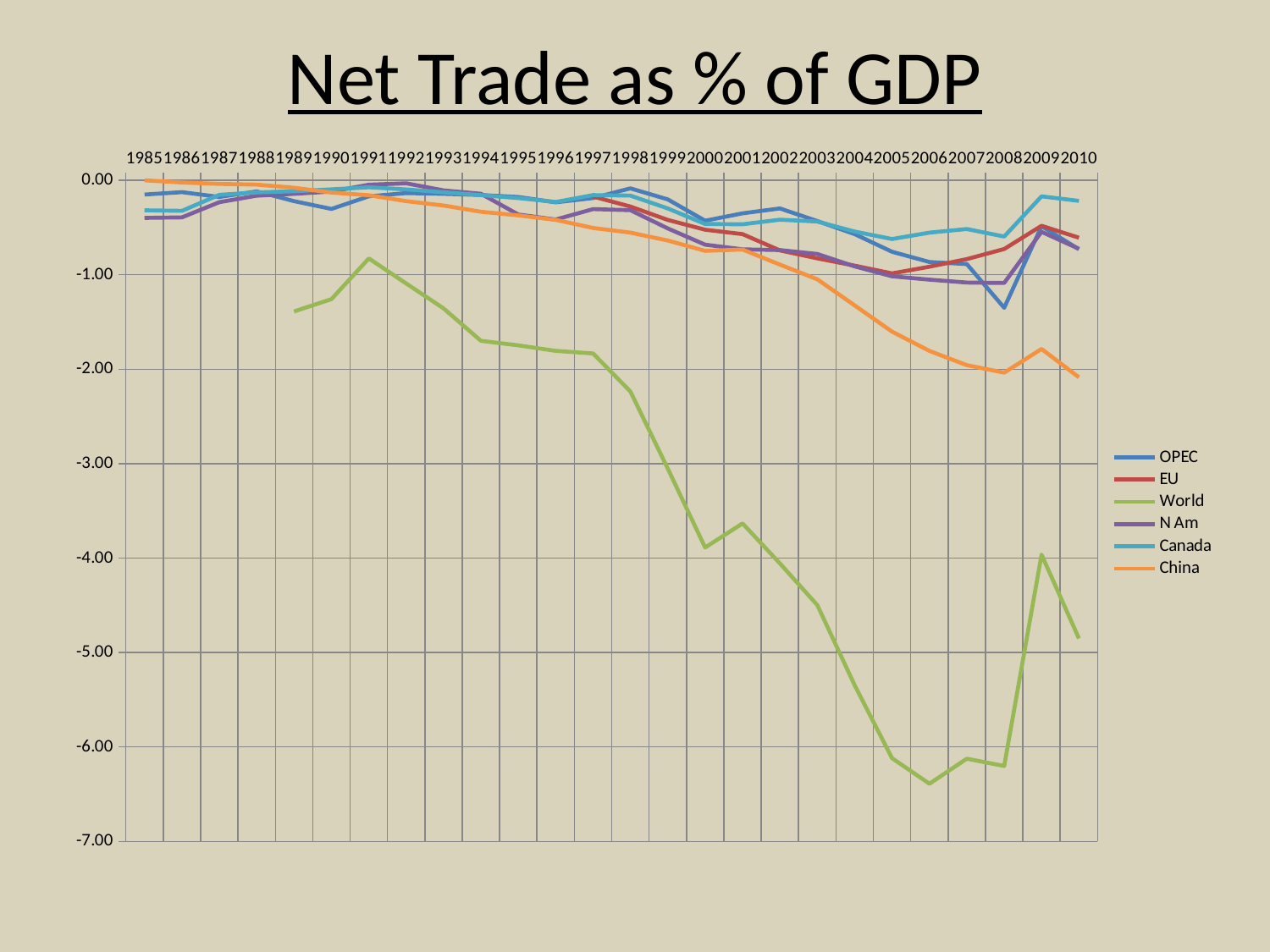
Which series is drawn in orange in the legend? China Is the value for World in 2003 greater or less than -4.00? less Is the value for Canada in 2010 greater or less than -1.00? greater Does the World line rise or fall between 1991 and 2006? fall Which series has the lowest value in 2006? World How many series does the legend list? 6 What is the title of the chart? Net Trade as % of GDP What kind of chart is shown on the slide? line chart Which series has the highest value in 2010? Canada How many years are shown along the x axis? 26 Is the value for World in 2006 greater or less than -6.00? less